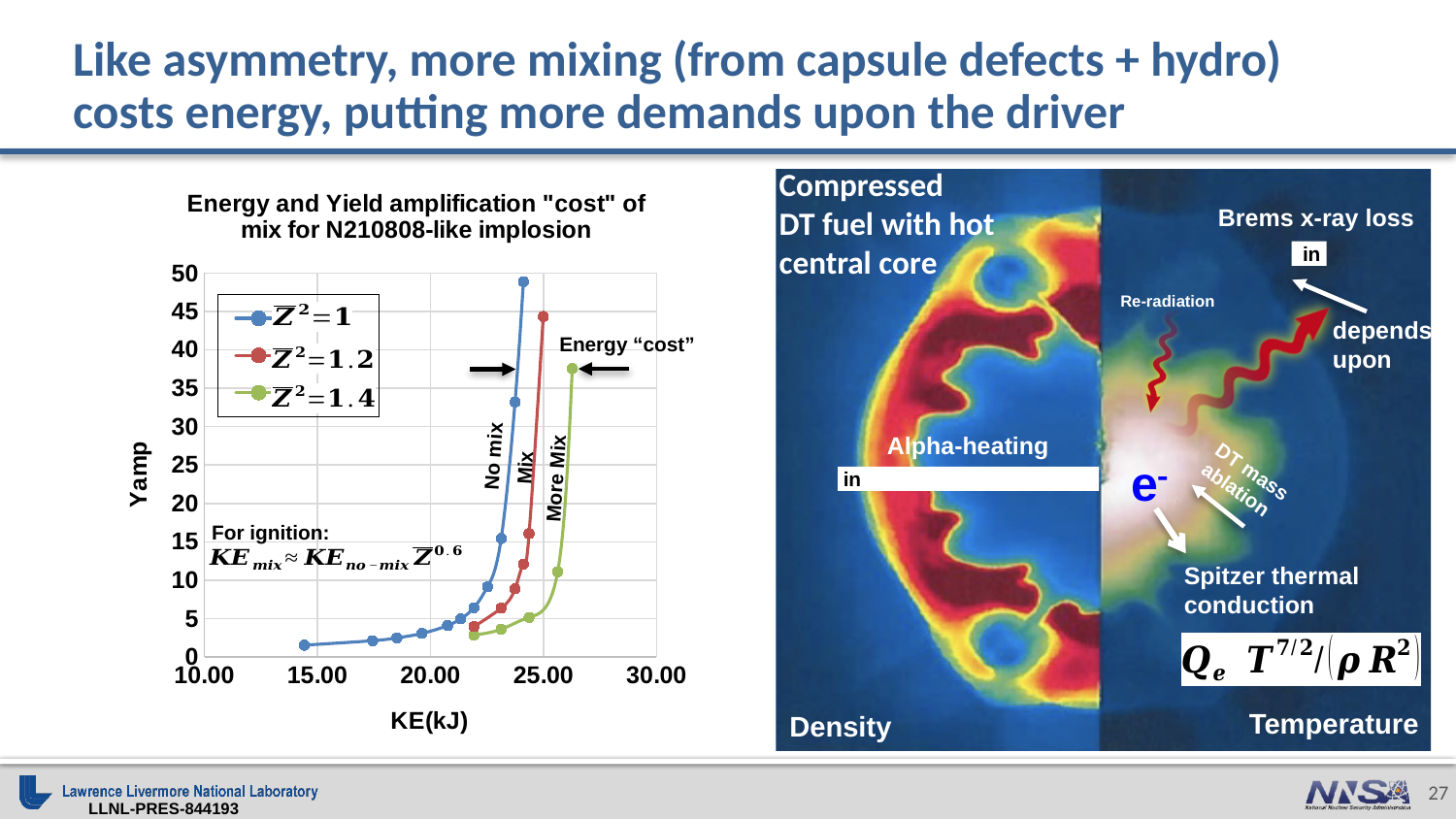
Is the highest Yamp value of the Z²=1 series greater or less than 45? greater Is the highest Yamp value of the Z²=1.4 series greater or less than 40? less What kind of chart is shown on the slide? line chart What is the label of the x axis of the chart? KE(kJ) Is the Yamp value of the first (leftmost) point of the Z²=1 series greater or less than 5? less Which series requires the highest KE to reach a given Yamp, i.e. lies furthest to the right on the chart? Z²=1.4 Which series reaches a higher maximum Yamp, Z²=1.2 or Z²=1.4? Z²=1.2 Which series reaches the lowest maximum Yamp value on the chart? Z²=1.4 How many series does the chart's legend list? 3 Does Yamp rise or fall as KE increases along the x axis for each series? rise Which series reaches the highest Yamp value on the chart? Z²=1 What is the title of the chart? Energy and Yield amplification "cost" of mix for N210808-like implosion